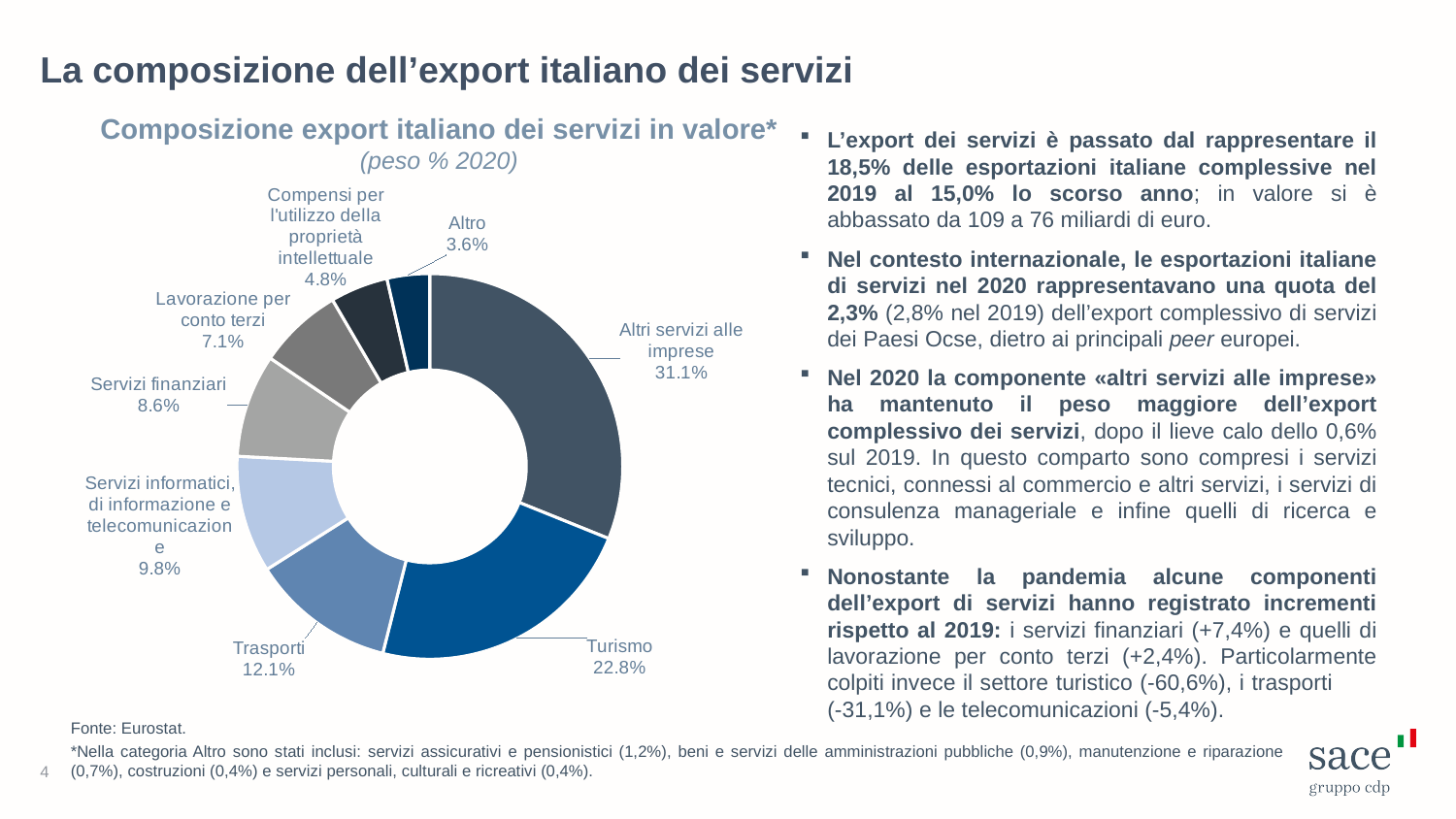
Which has a larger share, "Trasporti" or "Servizi informatici, di informazione e telecomunicazione"? Trasporti What is the value for "Servizi finanziari" in the chart? 8.6% What percentage is shown for "Trasporti"? 12.1% What is the value shown for "Turismo" in the chart? 22.8% What share of Italian services exports does "Altri servizi alle imprese" account for in the chart? 31.1% What is the difference in percentage points between "Altri servizi alle imprese" and "Turismo"? 8.3 Which category has the largest share in the chart? Altri servizi alle imprese What kind of chart is shown on the slide? Doughnut (pie) chart How many categories are shown in the chart? 8 What share is shown for "Compensi per l'utilizzo della proprietà intellettuale"? 4.8% Which category has the smallest share in the chart? Altro What is the title of the chart? Composizione export italiano dei servizi in valore* (peso % 2020)